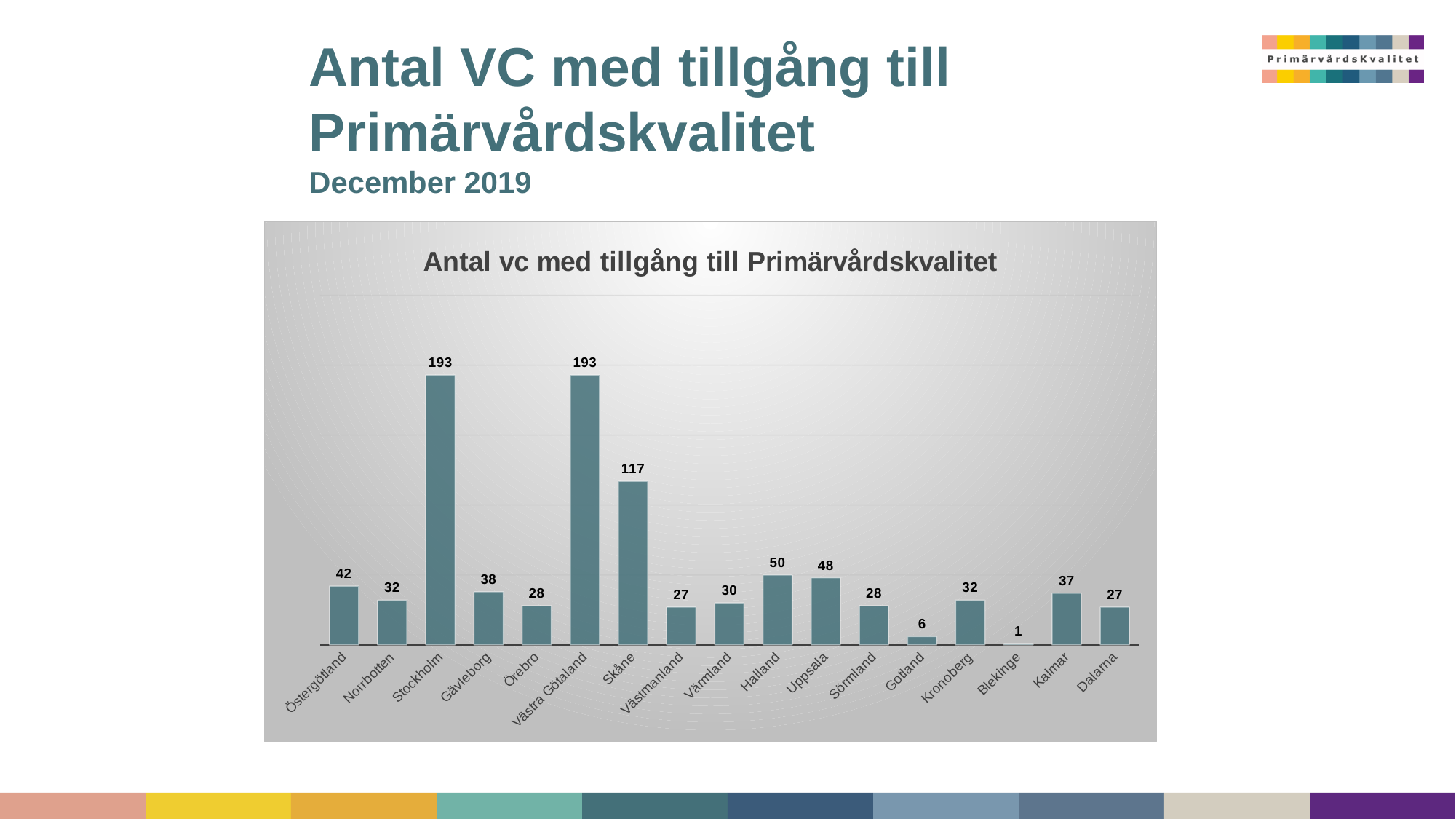
How many regions are shown on the x axis? 17 What is the value for Kalmar? 37 Which two regions share the highest value of 193? Stockholm and Västra Götaland Which has a larger value, Halland or Uppsala? Halland What kind of chart is shown? Bar chart Which region has the lowest value? Blekinge What is the value for Gotland? 6 What is the difference between the values for Stockholm and Skåne? 76 What is the value for Halland? 50 What is the difference between the values for Östergötland and Norrbotten? 10 What is the title of the chart? Antal vc med tillgång till Primärvårdskvalitet What is the value for Skåne? 117